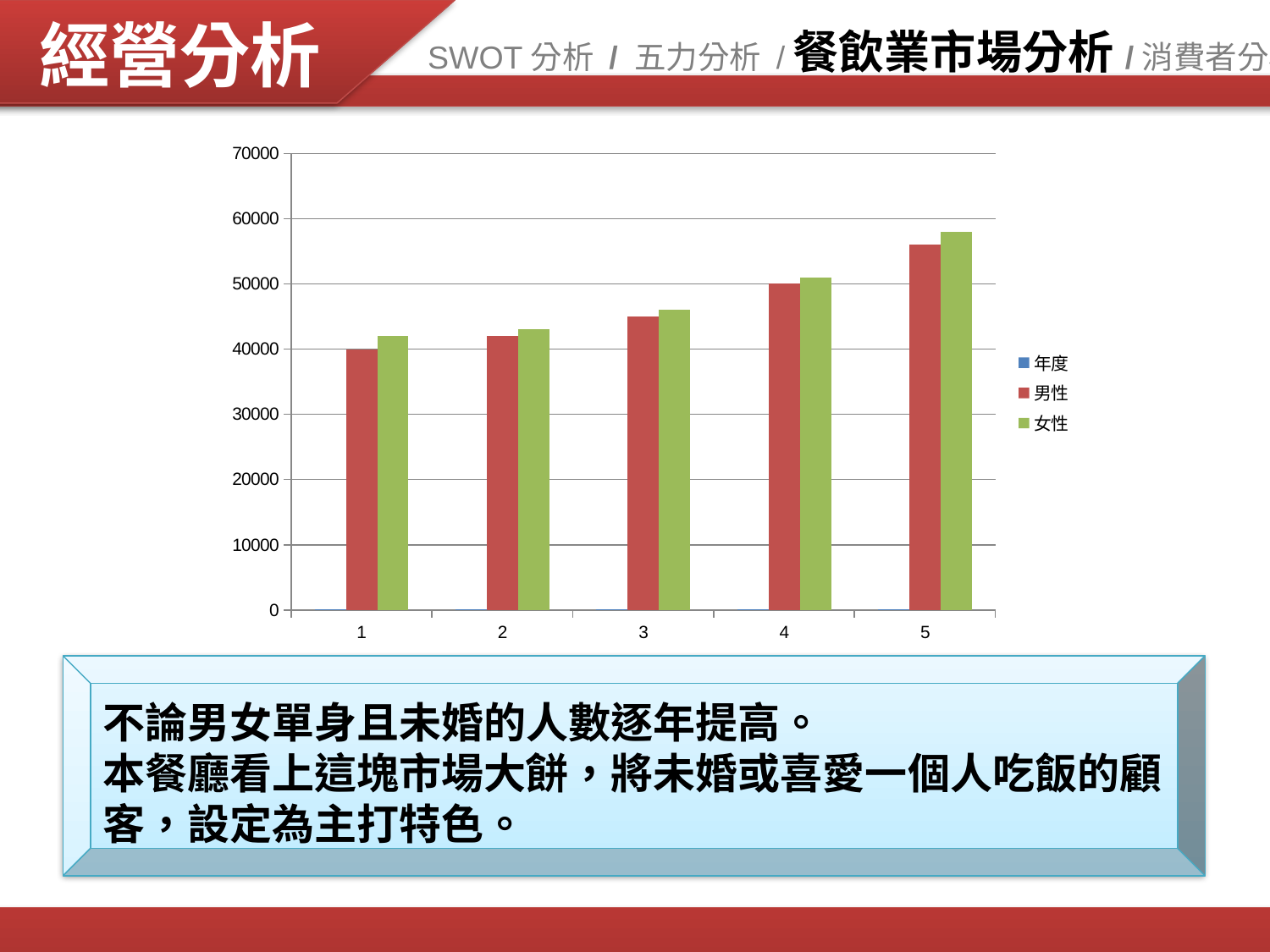
Which category has the lowest value for 男性? 1 Is the value for 女性 at category 5 greater or less than 60000? less Do the values for 男性 rise or fall from category 1 to category 5? rise How many categories are shown on the x axis? 5 Which category has the highest value for 女性? 5 Is the value for 男性 at category 5 greater or less than 50000? greater What kind of chart is shown on the slide? bar chart Is the value for 女性 at category 2 greater or less than 50000? less How many series does the legend list? 3 Which is larger at category 5, 男性 or 女性? 女性 What colour are the 女性 bars? green